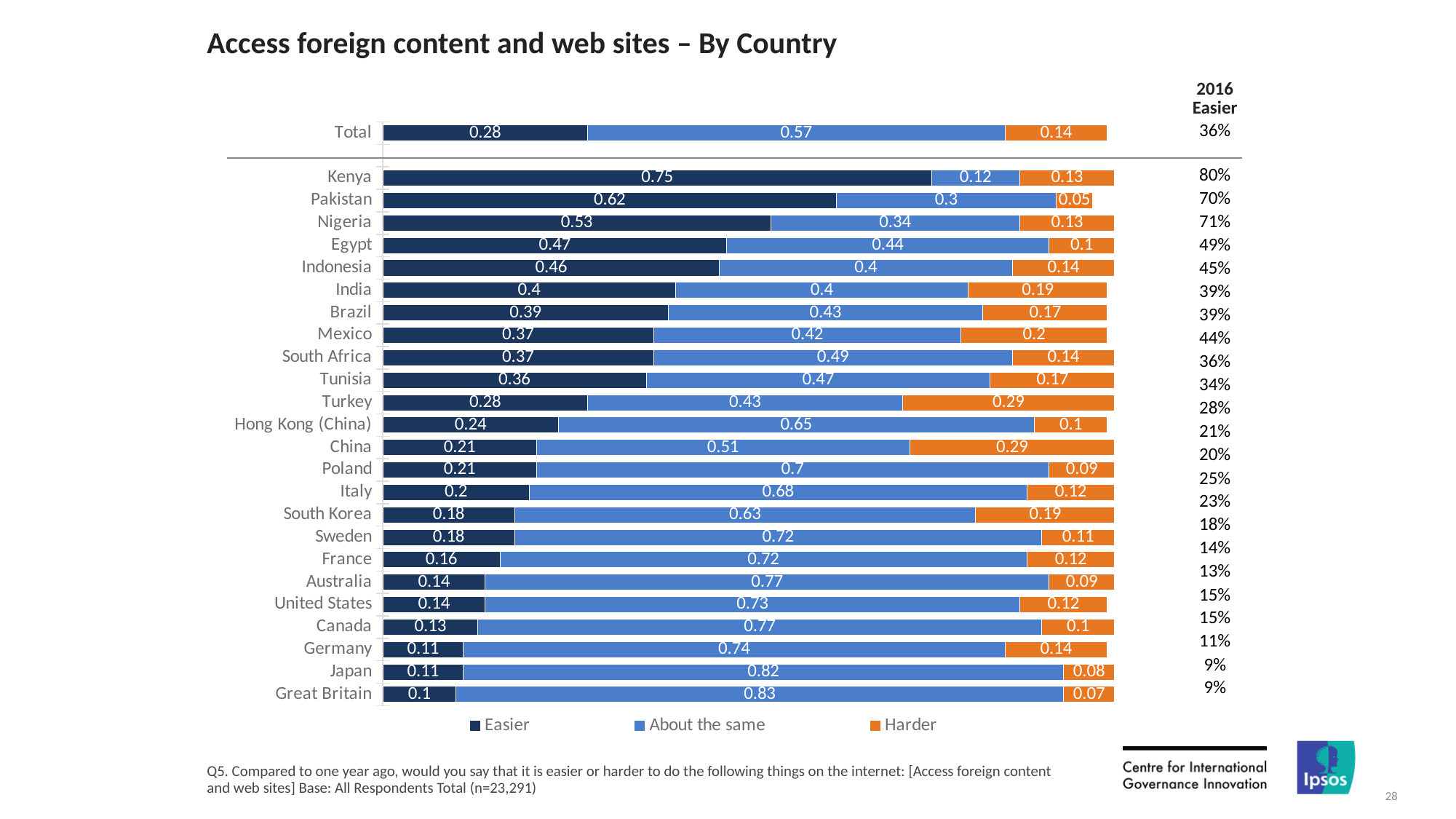
How many bars (including Total) are plotted in the chart? 25 What kind of chart is shown on the slide? Stacked bar chart Which country has the highest 'Easier' value? Kenya What is the total of the three segments in the Kenya bar? 1 What is the 'Easier' value for Kenya? 0.75 What is the difference between the 'Easier' values for Kenya and Pakistan? 0.13 Which country has the lowest 'Easier' value? Great Britain What is the '2016 Easier' figure shown for Kenya at the right of the chart? 80% How many series does the legend list? 3 What is the 'Harder' value for Turkey? 0.29 What is the 'About the same' value for Japan? 0.82 Which is larger, the 'Harder' value for Turkey or for Poland? Turkey